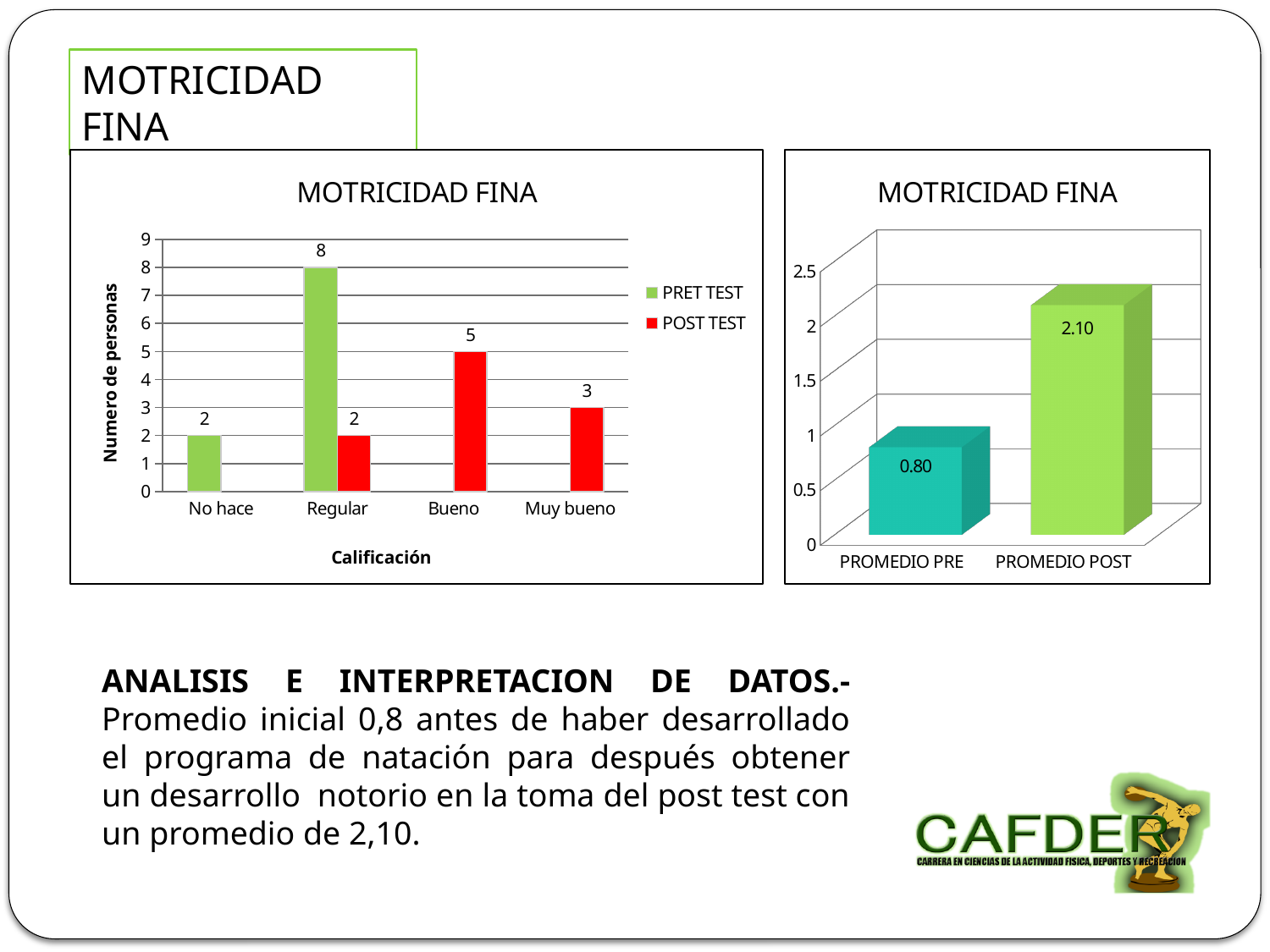
In the left chart, what is the difference between the PRET TEST and POST TEST values for Regular? 6 In the left chart, how many series does the legend list? 2 In the right chart, what is the difference between PROMEDIO POST and PROMEDIO PRE? 1.30 In the left chart, what is the PRET TEST value for Regular? 8 In the right chart, what is the value for PROMEDIO POST? 2.10 In the left chart, how many categories are shown on the x axis? 4 In the left chart, what is the POST TEST value for Muy bueno? 3 In the left chart, which category has the highest POST TEST value? Bueno In the left chart, what is the PRET TEST value for No hace? 2 In the left chart, what is the POST TEST value for Bueno? 5 In the left chart, which category has the highest PRET TEST value? Regular What kind of chart is the right chart? Bar chart